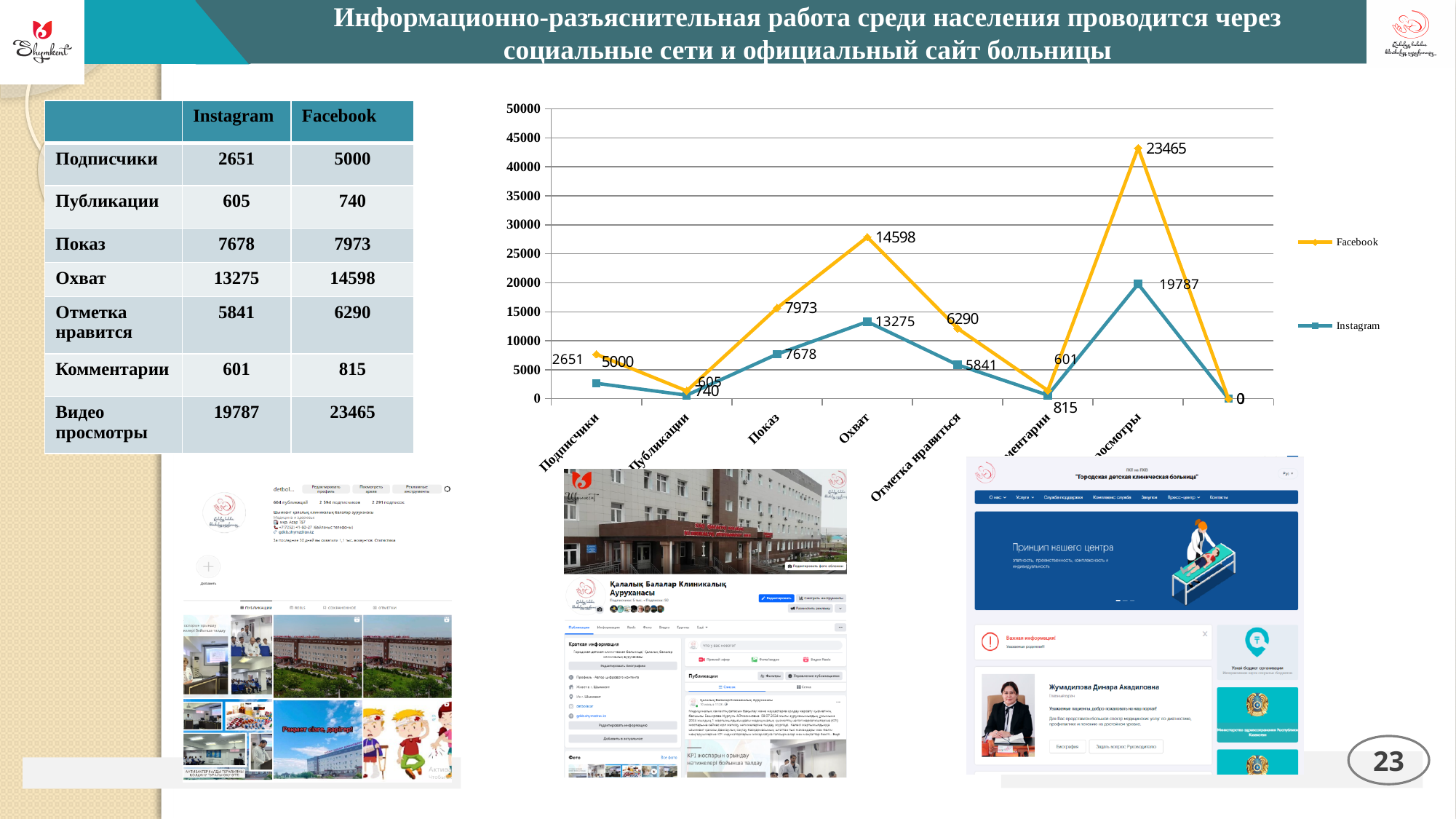
What is the Instagram value for Комментарии in the chart? 601 For which category does the Instagram series reach its highest value? Видео просмотры For which category does the Facebook series reach its highest value? Видео просмотры For Подписчики, which series has the larger value, Facebook or Instagram? Facebook What colour is the Facebook line in the chart? Yellow What type of chart is shown on the slide? Line chart What is the difference between the Facebook and Instagram values for Охват? 1323 What is the Facebook value for Видео просмотры in the chart? 23465 What is the difference between the Facebook and Instagram values for Видео просмотры? 3678 What is the Facebook value for Показ in the chart? 7973 What is the Instagram value for Охват in the chart? 13275 How many series does the chart's legend list? 2